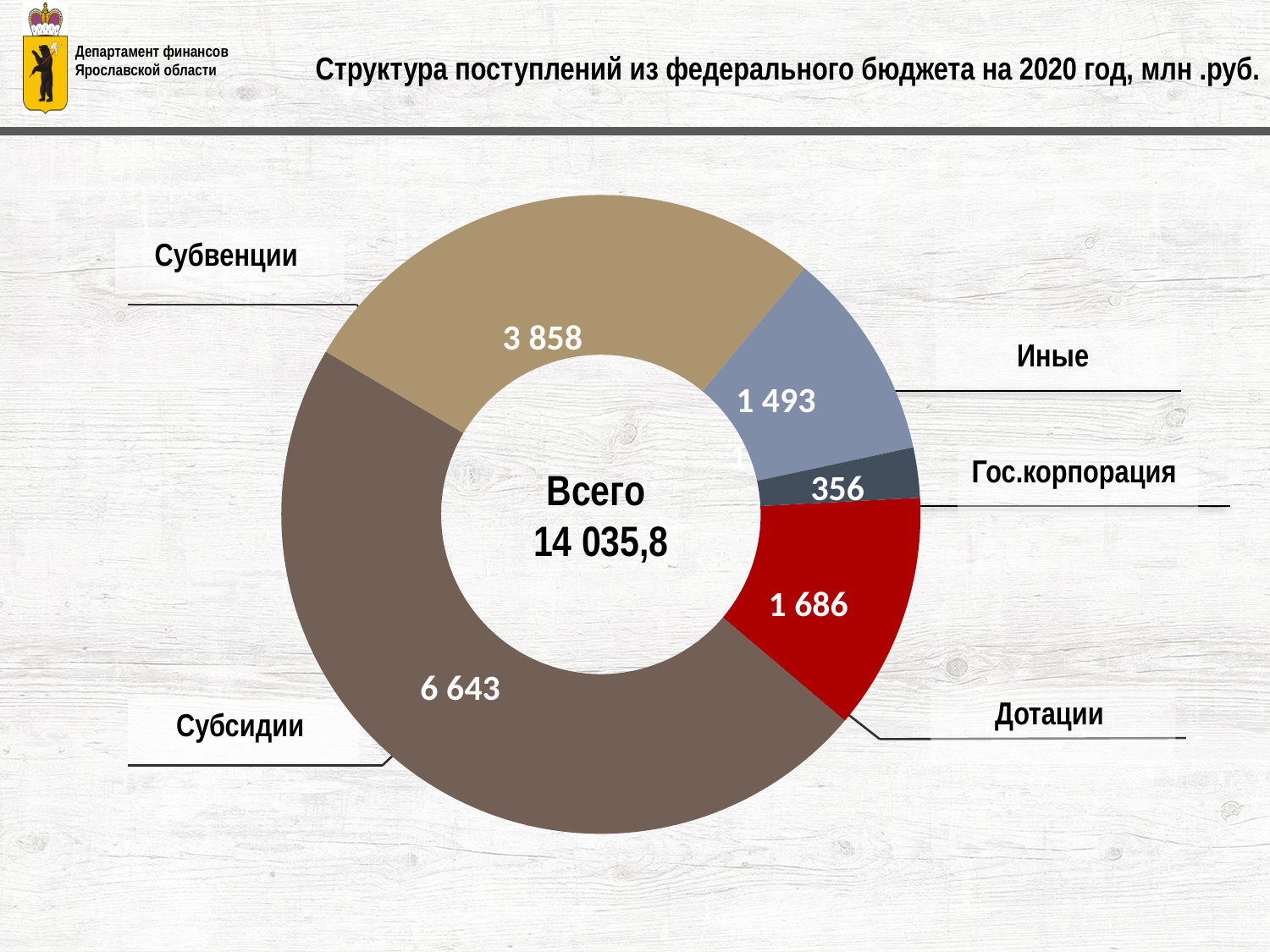
What kind of chart is shown on the slide? doughnut chart What is the difference between the values for Субсидии and Субвенции? 2 785 Which category has the smallest value? Гос.корпорация How many categories does the chart show? 5 What is the value for Дотации? 1 686 What is the value for Иные? 1 493 What total (Всего) is shown in the centre of the chart? 14 035,8 Which is larger, the value for Дотации or the value for Иные? Дотации What is the value for Субвенции? 3 858 Which category has the largest value? Субсидии What is the value for Субсидии? 6 643 What is the value for Гос.корпорация? 356